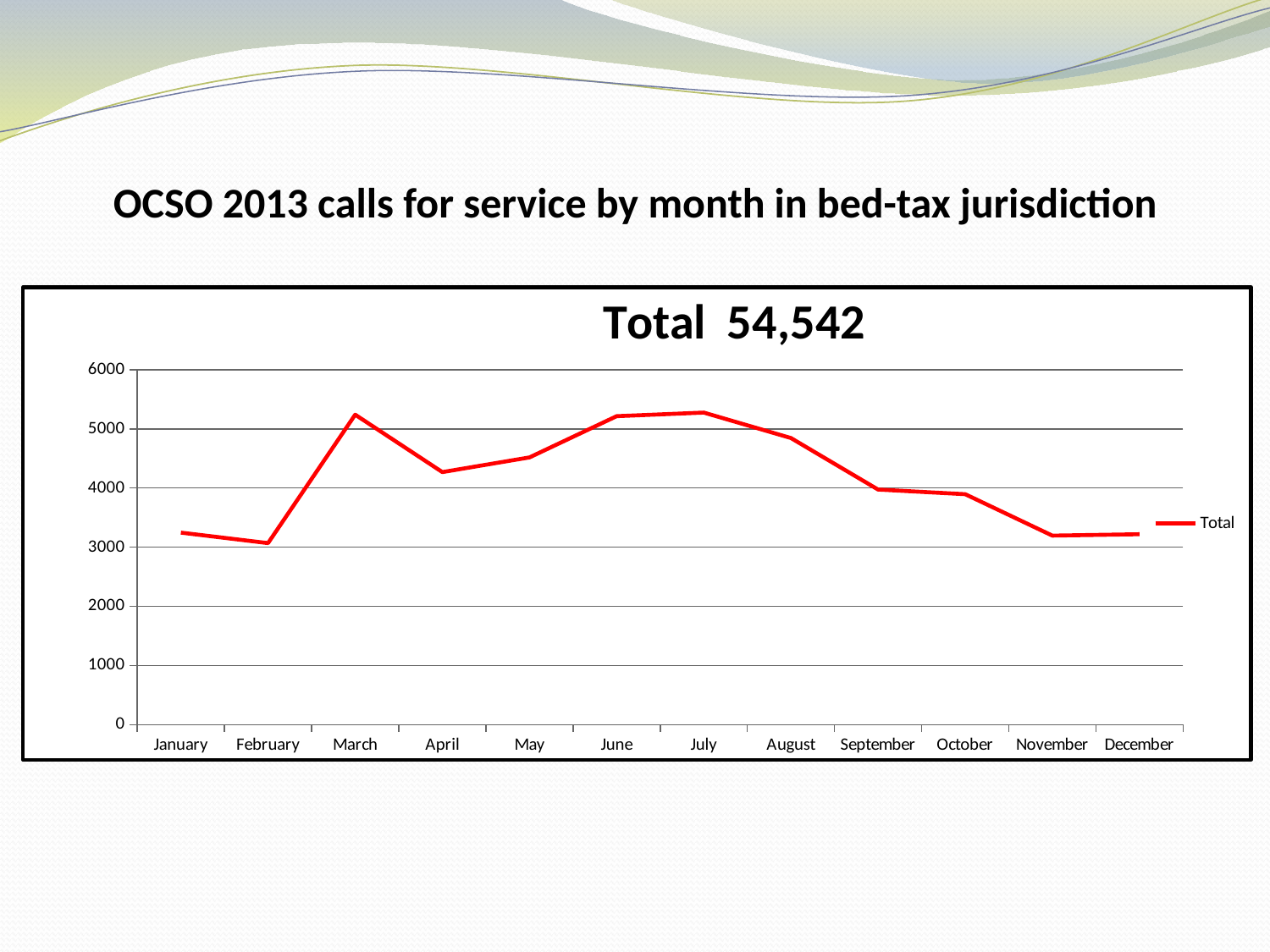
What is the name of the series in the legend? Total What kind of chart is shown on the slide? line chart What is the title shown above the chart? Total 54,542 Which month has the lowest value? February Do the values rise or fall from September to November? fall Which is larger, the value for March or the value for April? March Is the value for April greater or less than 5000? less How many months are plotted along the x axis? 12 Is the value for January greater or less than 3000? greater Which is larger, the value for February or the value for June? June Is the value for March greater or less than 5000? greater How many series does the legend list? 1